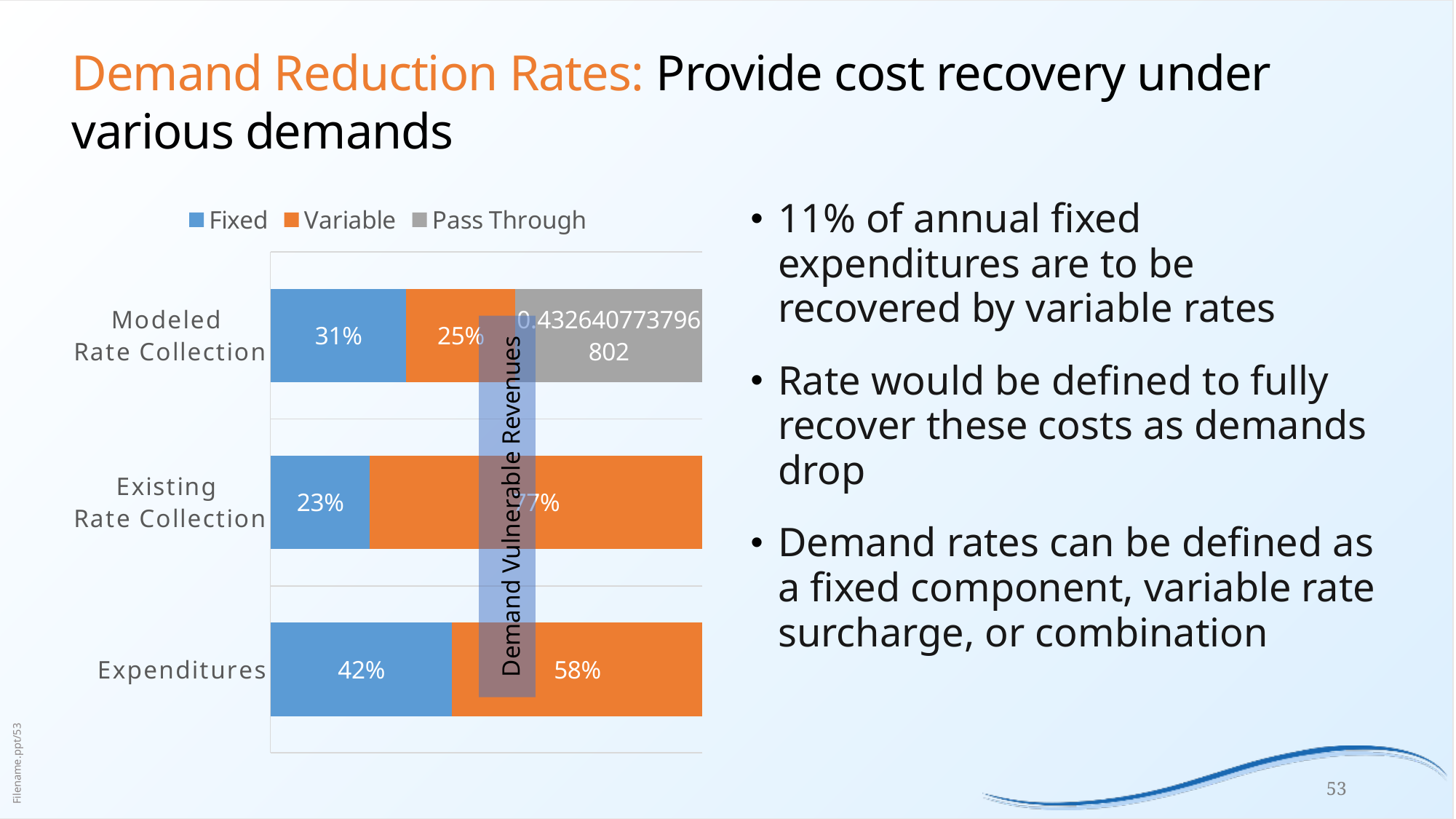
What is the difference between the Variable value for Existing Rate Collection and the Variable value for Expenditures? 19% What is the Variable value for Existing Rate Collection? 77% How many series does the chart legend list? 3 What is the Fixed value for Modeled Rate Collection? 31% What is the Fixed value for Expenditures? 42% What kind of chart is shown on the slide? Stacked bar chart Which series is shown in grey in the legend? Pass Through What is the Variable value for Expenditures? 58% What is the Fixed value for Existing Rate Collection? 23% What is the Variable value for Modeled Rate Collection? 25% How many categories are plotted on the chart? 3 Which category has the highest Fixed value? Expenditures